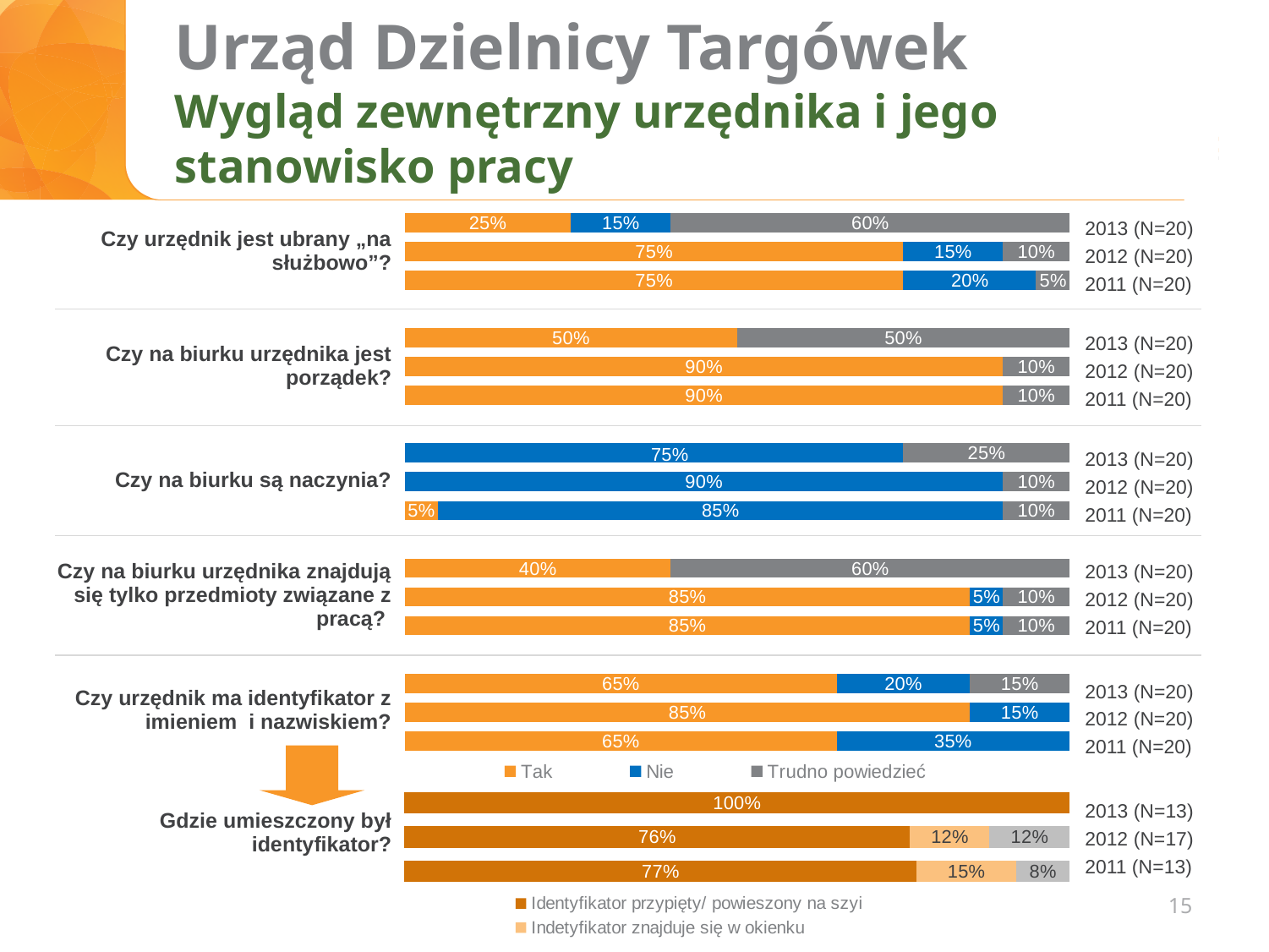
What type of chart is used on this slide? Stacked bar chart In the chart "Czy na biurku są naczynia?", what is the difference between the "Nie" share in 2012 and in 2013? 15% In the chart "Czy na biurku urzędnika jest porządek?", what percentage answered "Tak" in 2012? 90% In the chart "Czy urzędnik jest ubrany „na służbowo”?", what percentage answered "Tak" in 2013? 25% In the chart "Czy urzędnik ma identyfikator z imieniem i nazwiskiem?", what percentage answered "Tak" in 2012? 85% In the chart "Czy na biurku są naczynia?", what percentage answered "Nie" in 2011? 85% In the chart "Czy na biurku urzędnika jest porządek?", which year has the lowest "Tak" share? 2013 In the chart "Gdzie umieszczony był identyfikator?", what percentage in 2013 had the identifier pinned/hung on the neck? 100% In the chart "Czy na biurku urzędnika znajdują się tylko przedmioty związane z pracą?", what percentage answered "Tak" in 2013? 40% In the chart "Czy urzędnik ma identyfikator z imieniem i nazwiskiem?", which is larger: the "Nie" share in 2011 or in 2013? 2011 In the chart "Gdzie umieszczony był identyfikator?", what is the sample size (N) for 2012? N=17 In the chart "Czy urzędnik jest ubrany „na służbowo”?", what percentage answered "Trudno powiedzieć" in 2013? 60%